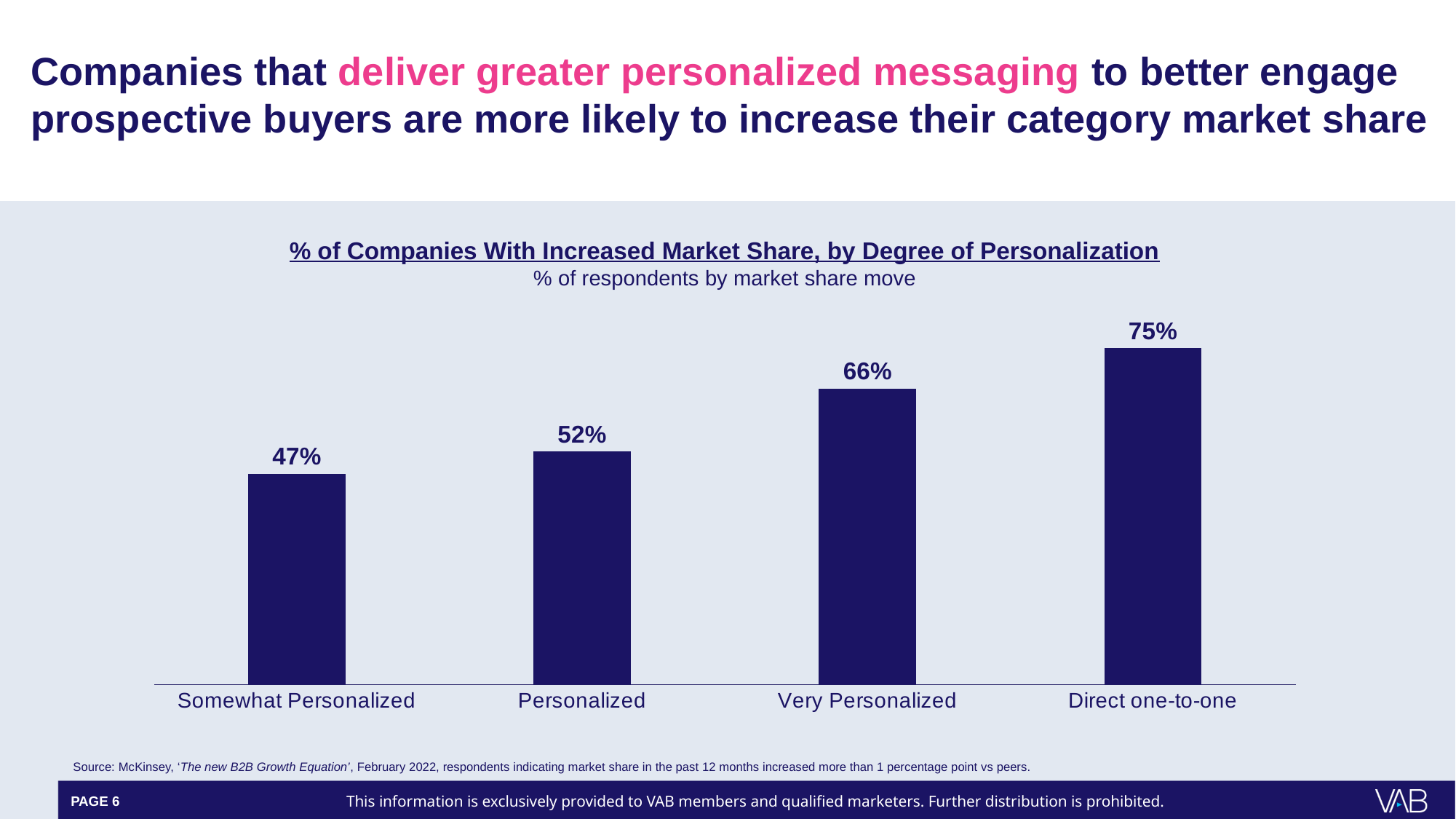
How many categories are shown on the chart? 4 Which is larger, the value for Very Personalized or the value for Personalized? Very Personalized Do the values rise or fall from Somewhat Personalized to Direct one-to-one? Rise Which degree of personalization has the lowest percentage of companies with increased market share? Somewhat Personalized What is the value for Very Personalized? 66% What is the value for Somewhat Personalized? 47% What kind of chart is shown on the slide? Bar chart What is the value for Direct one-to-one? 75% What is the value for Personalized? 52% Which degree of personalization has the highest percentage of companies with increased market share? Direct one-to-one What is the difference between the values for Very Personalized and Personalized? 14% What is the difference between the values for Direct one-to-one and Somewhat Personalized? 28%